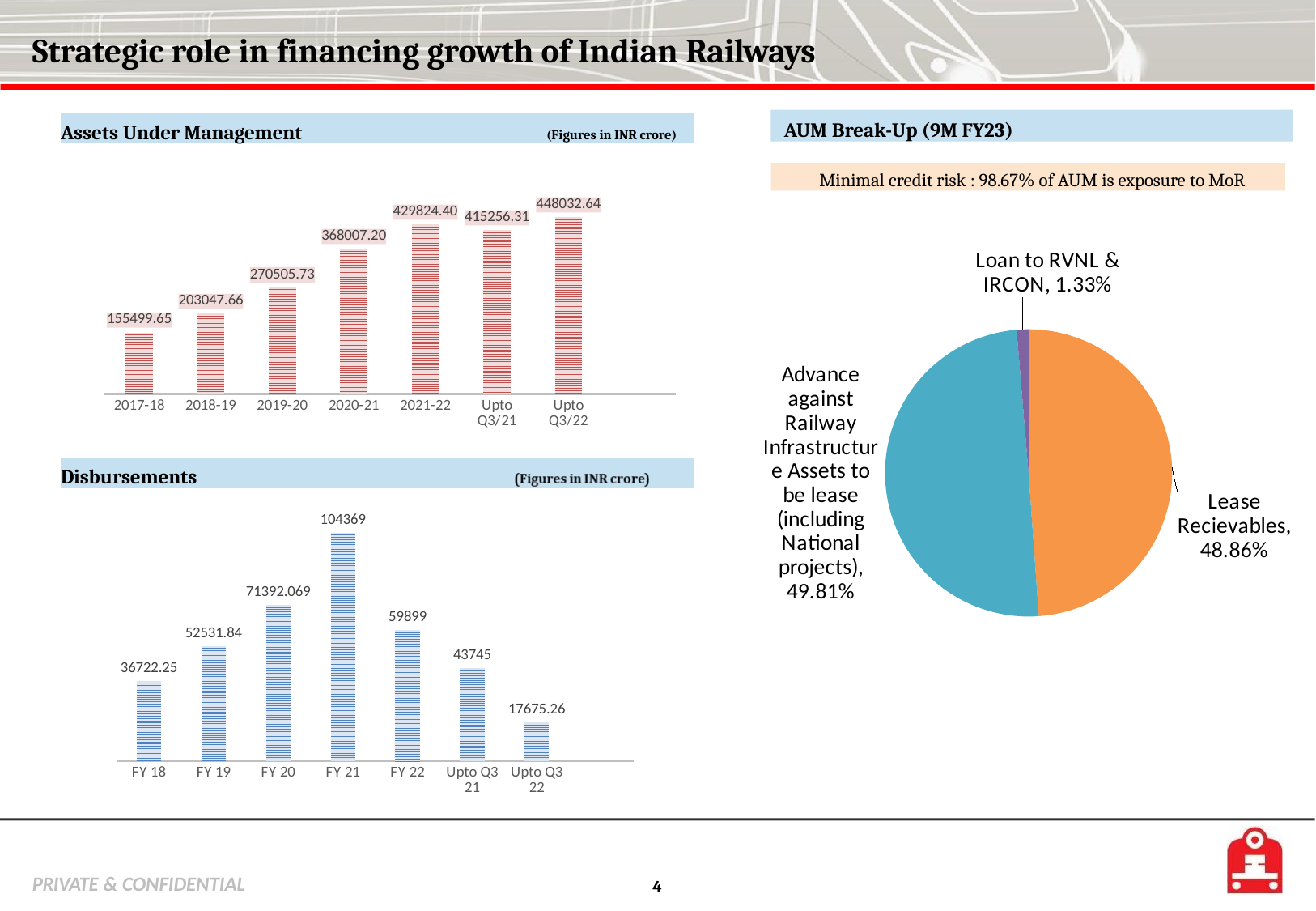
What kind of chart is the AUM Break-Up (9M FY23) chart? Pie chart In the Assets Under Management chart, which category has the lowest value? 2017-18 In the Disbursements chart, which category has the lowest value? Upto Q3 22 In the AUM Break-Up (9M FY23) pie chart, what share is Lease Recievables? 48.86% In the Assets Under Management chart, what is the value for 2019-20? 270505.73 In the Disbursements chart, which is larger: the value for FY 19 or the value for Upto Q3 21? FY 19 In the Disbursements chart, what is the difference between the FY 21 value and the FY 22 value? 44470 In the Disbursements chart, which category has the highest value? FY 21 In the Assets Under Management chart, which category has the highest value? Upto Q3/22 In the Disbursements chart, what is the value for FY 20? 71392.069 In the Assets Under Management chart, how many bars are plotted? 7 In the Assets Under Management chart, what is the difference between the 2021-22 value and the 2020-21 value? 61817.20